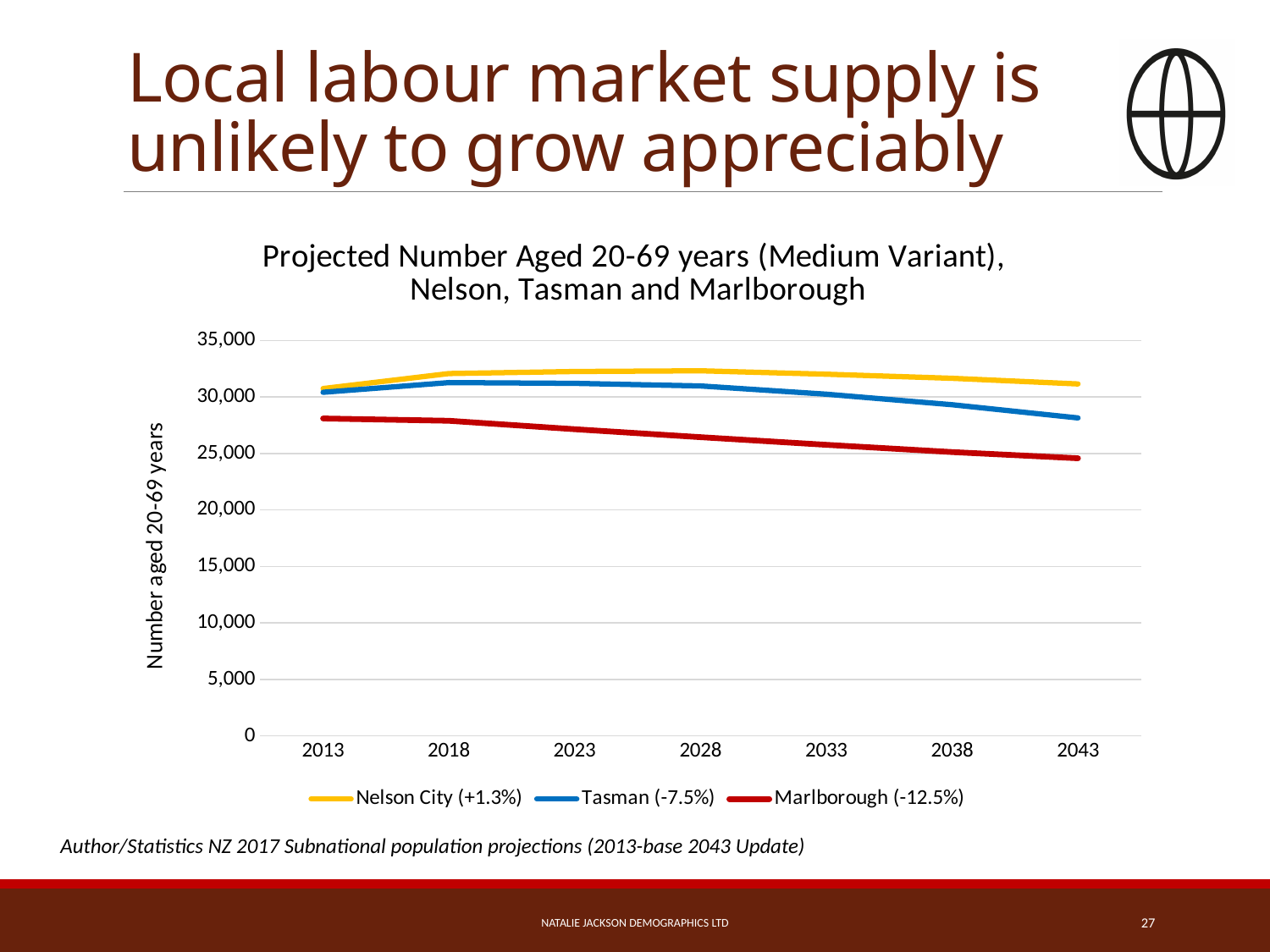
Does the Marlborough (-12.5%) line rise or fall from 2013 to 2043? Fall Is the value for Tasman (-7.5%) in 2043 greater or less than 30,000? less What is the label on the vertical axis of the chart? Number aged 20-69 years What kind of chart is shown on the slide? Line chart Is the value for Marlborough (-12.5%) in 2043 greater or less than 25,000? less How many series does the legend list? 3 Which series has the highest value in 2043? Nelson City (+1.3%) Is the value for Nelson City (+1.3%) in 2013 greater or less than 30,000? greater In 2043, which is larger: the value for Nelson City (+1.3%) or the value for Marlborough (-12.5%)? Nelson City (+1.3%) Does the Tasman (-7.5%) line rise or fall between 2023 and 2043? Fall Which series has the lowest value in 2013? Marlborough (-12.5%) How many years are marked along the x axis? 7